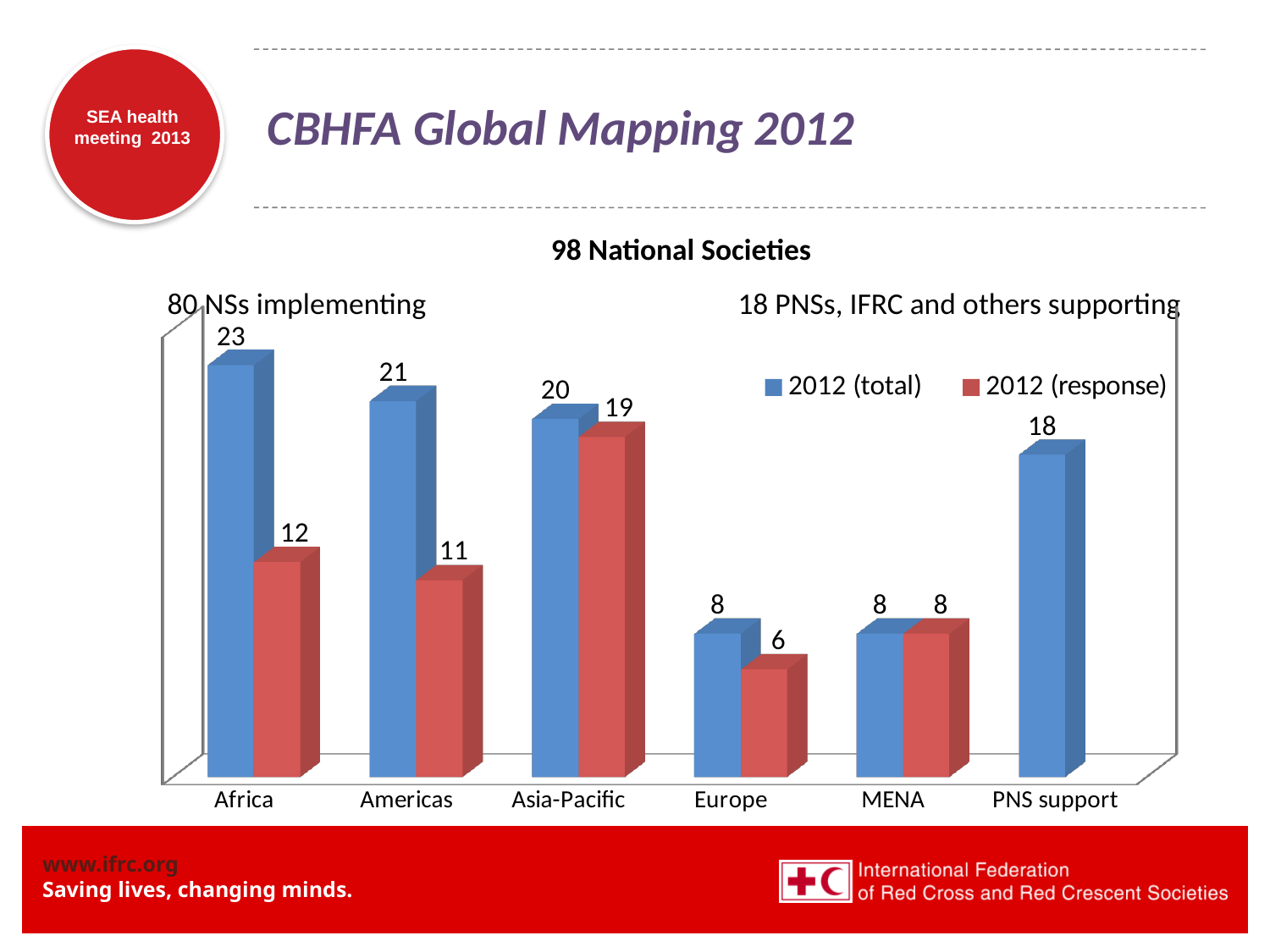
How many categories are shown on the x axis? 6 What is the 2012 (total) value for PNS support? 18 What kind of chart is shown on the slide? bar chart What is the 2012 (total) value for Africa? 23 What is the difference between the 2012 (total) and 2012 (response) values for Americas? 10 What is the 2012 (response) value for Asia-Pacific? 19 Which category has the highest 2012 (total) value? Africa Which category has the lowest 2012 (response) value? Europe How many series does the legend list? 2 What colour are the 2012 (response) bars? red Which is larger, the 2012 (response) value for Africa or for Asia-Pacific? Asia-Pacific What is the title of the chart? 98 National Societies